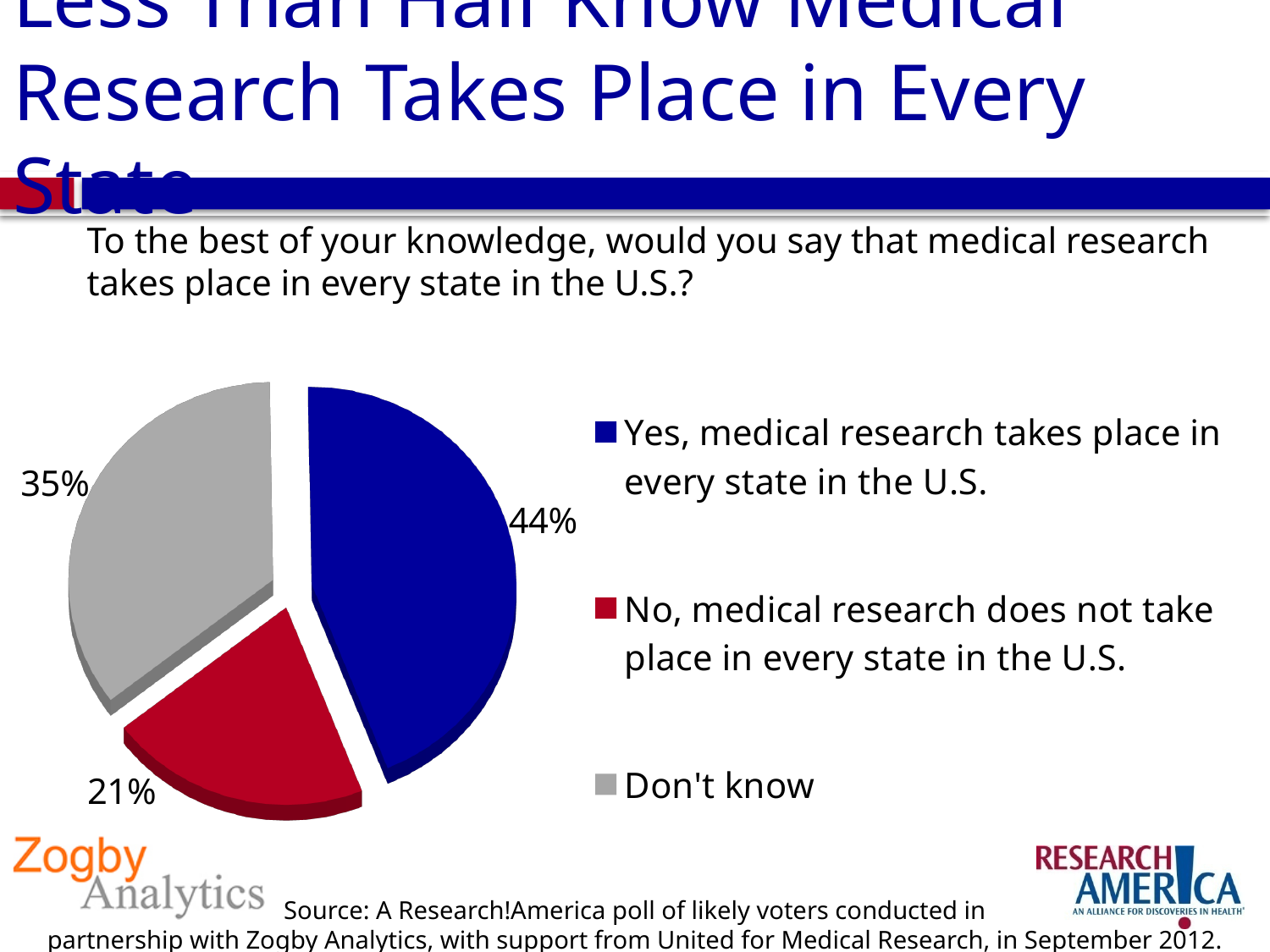
What is the difference in percentage points between the "Yes" and "No" responses? 23 Which response has the largest share of the pie? Yes, medical research takes place in every state in the U.S. How many entries does the legend list? 3 What percentage of respondents said yes, medical research takes place in every state in the U.S.? 44% What colour is the slice for "Don't know"? Gray Which is larger: the share for "Don't know" or the share for "No, medical research does not take place in every state in the U.S."? Don't know What is the difference in percentage points between the "Don't know" and "No" responses? 14 What percentage of respondents answered "Don't know"? 35% What kind of chart is shown on the slide? Pie chart Which response has the smallest share of the pie? No, medical research does not take place in every state in the U.S. What percentage of respondents said no, medical research does not take place in every state in the U.S.? 21% How many slices does the pie chart have? 3